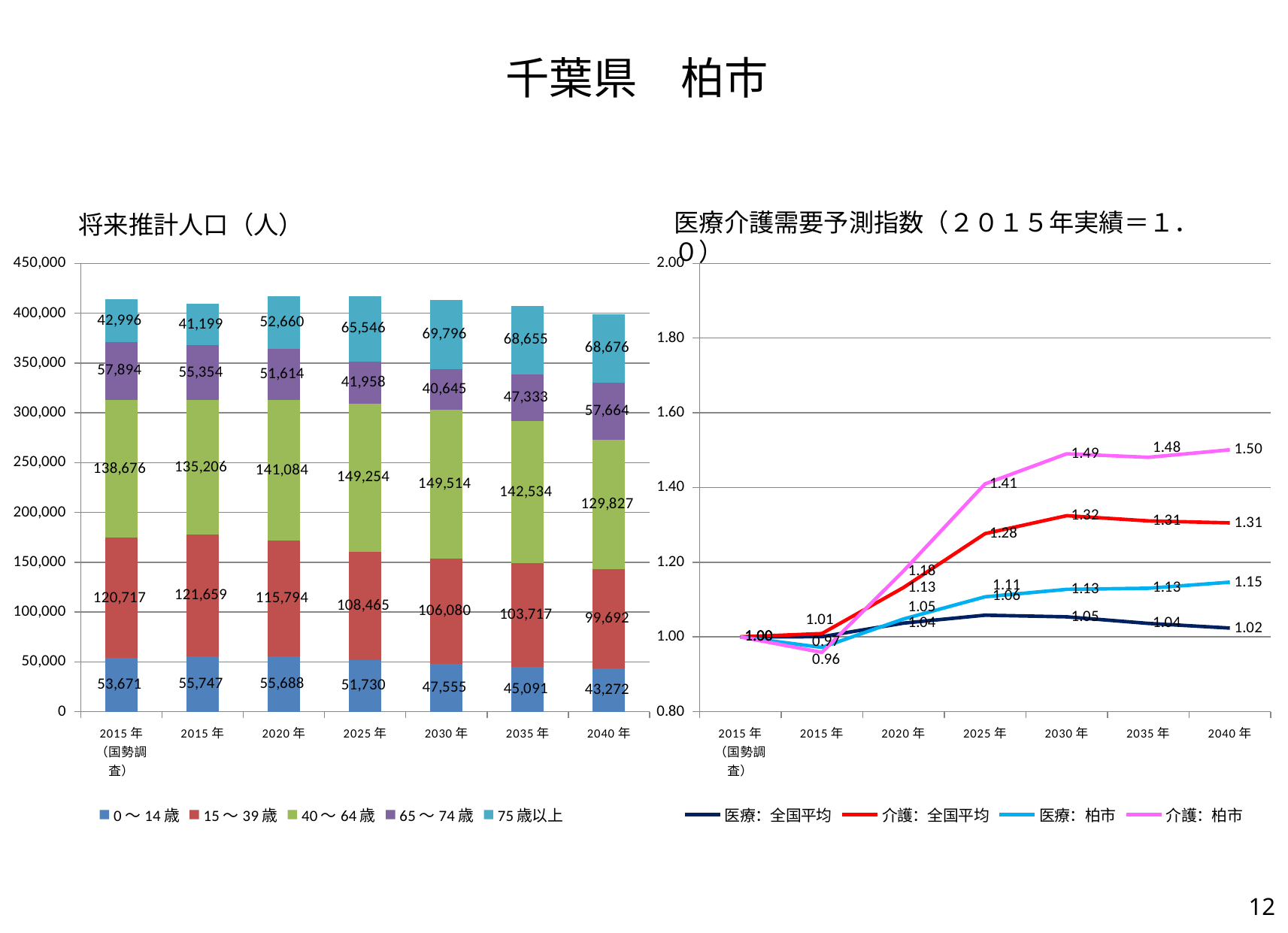
In the 医療介護需要予測指数 chart, which series is higher in 2030年, 介護：全国平均 or 医療：柏市? 介護：全国平均 In the 将来推計人口（人） chart, what is the value for 0～14歳 in 2040年? 43,272 What kind of chart is the 将来推計人口（人） chart? Stacked bar chart In the 将来推計人口（人） chart, what is the difference between the 75歳以上 value in 2040年 and in 2015年（国勢調査）? 25,680 In the 医療介護需要予測指数 chart, what is the value for 医療：全国平均 in 2040年? 1.02 In the 医療介護需要予測指数 chart, how many series does the legend list? 4 In the 将来推計人口（人） chart, how many series does the legend list? 5 In the 将来推計人口（人） chart, what is the total of the stacked bar for 2040年? 399,131 In the 将来推計人口（人） chart, what is the value for 75歳以上 in 2030年? 69,796 In the 医療介護需要予測指数 chart, what is the value for 介護：柏市 in 2040年? 1.50 In the 将来推計人口（人） chart, which year has the highest value for 40～64歳? 2030年 In the 将来推計人口（人） chart, which year has the lowest value for 15～39歳? 2040年